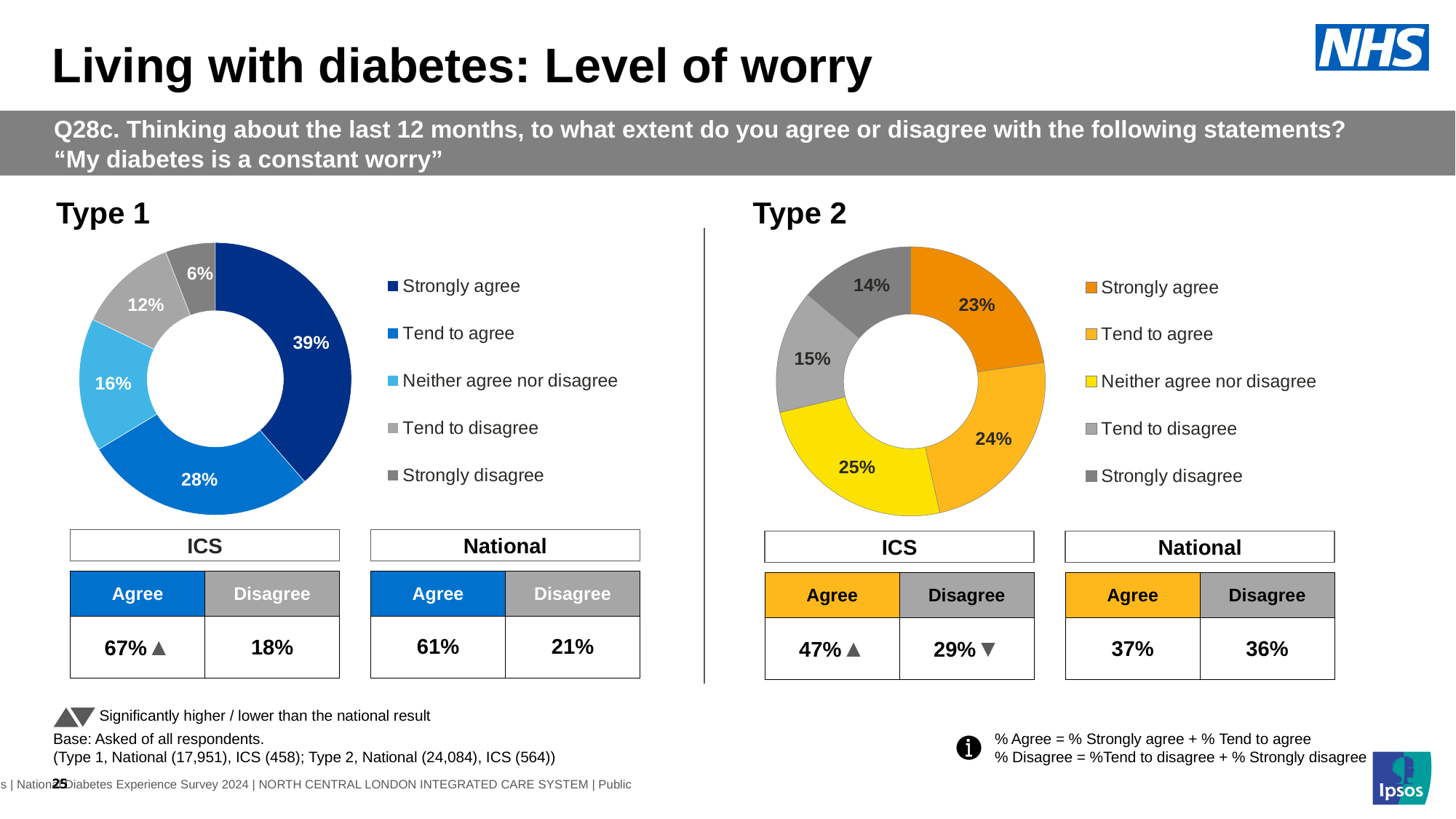
In the Type 1 chart, which is larger: Tend to agree or Neither agree nor disagree? Tend to agree In the Type 1 chart, what percentage of respondents strongly agree? 39% In the Type 2 chart, which response category has the smallest share? Strongly disagree How many response categories does the Type 1 chart's legend list? 5 In the Type 2 chart, what colour represents Neither agree nor disagree? Yellow What kind of chart is used for the Type 2 results? Doughnut (pie) chart In the Type 1 chart, which response category has the smallest share? Strongly disagree In the Type 1 chart, what is the combined share of Strongly agree and Tend to agree? 67% In the Type 2 chart, what is the difference between the Neither agree nor disagree share and the Strongly agree share? 2 percentage points In the Type 1 chart, which response category has the largest share? Strongly agree In the Type 2 chart, what percentage of respondents neither agree nor disagree? 25% In the Type 2 chart, which is larger: Tend to disagree or Strongly disagree? Tend to disagree